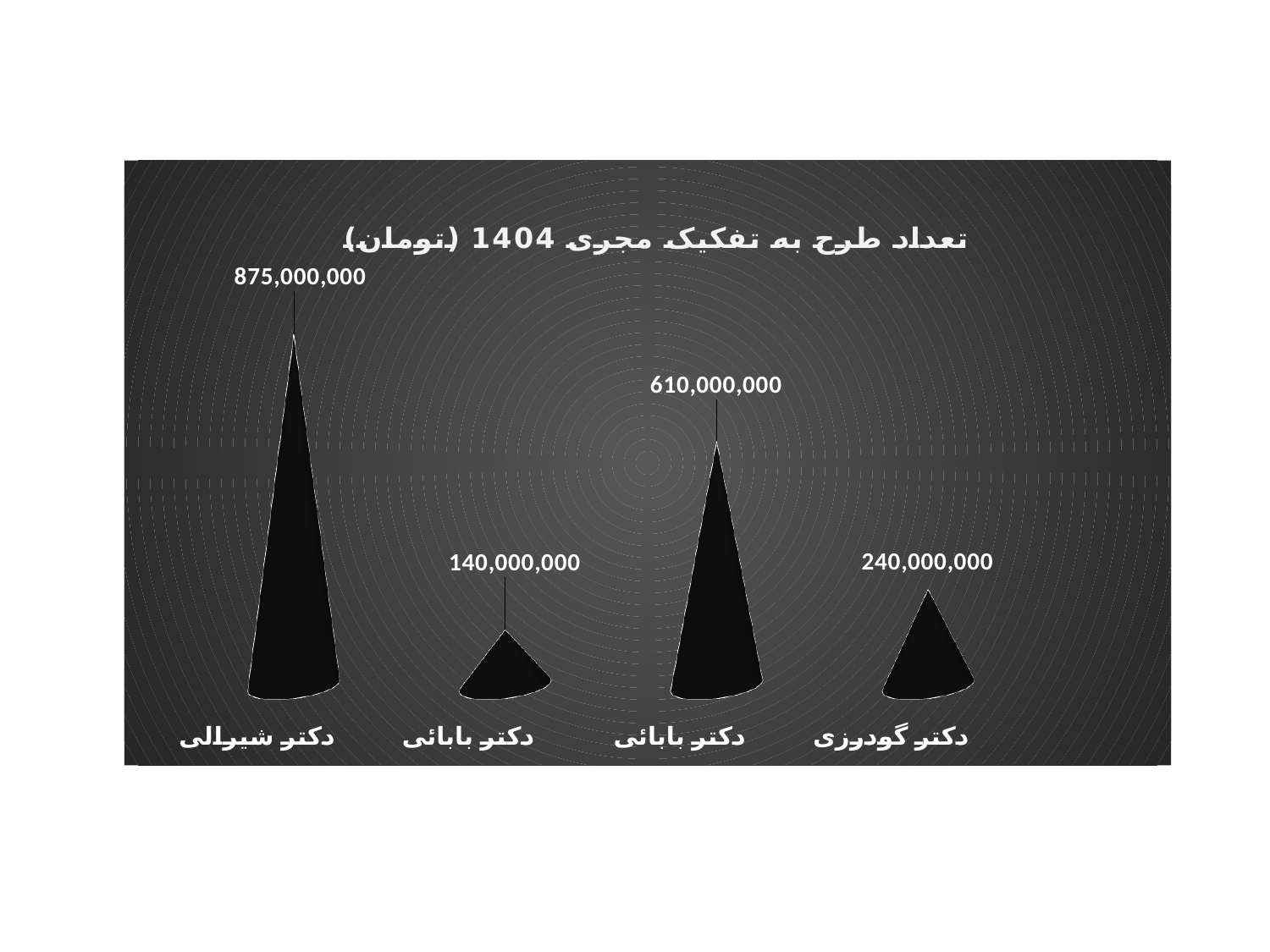
Which is larger, the value for دکتر گودرزی or the value for the second cone from the left (140,000,000)? دکتر گودرزی How many categories are plotted on the chart? 4 What is the value shown for the second cone from the left (labelled دکتر بابائی)? 140,000,000 What kind of chart is shown on the slide? Bar chart What is the difference between the values for دکتر شیرالی and دکتر گودرزی? 635,000,000 Which category has the highest value? دکتر شیرالی What is the title of the chart? تعداد طرح به تفکیک مجری 1404 (تومان) What is the value shown for دکتر شیرالی? 875,000,000 What is the lowest value shown on the chart? 140,000,000 What is the value shown for the third cone from the left (labelled دکتر بابائی)? 610,000,000 What is the difference between the two cones labelled دکتر بابائی? 470,000,000 What is the value shown for دکتر گودرزی? 240,000,000